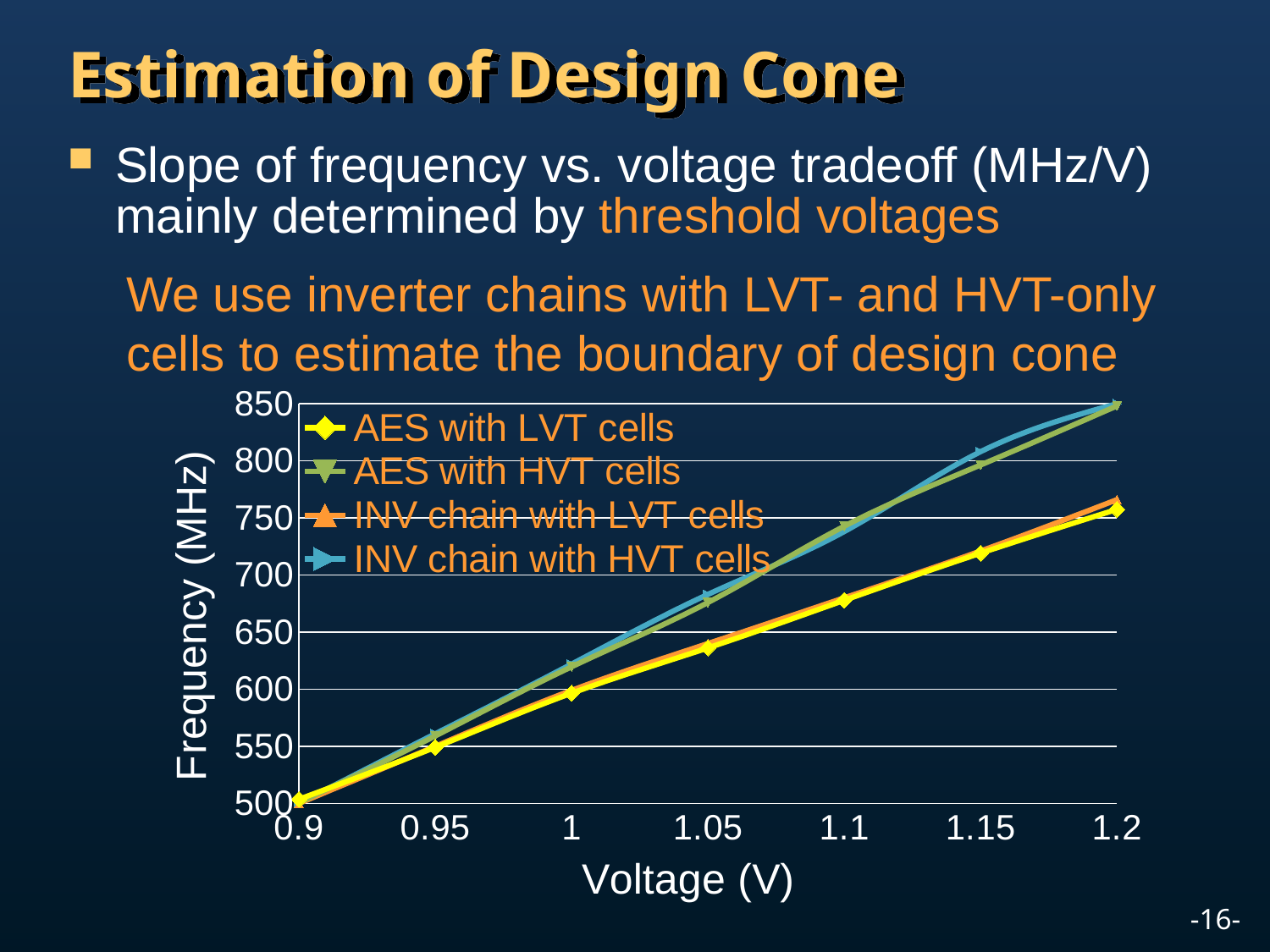
What kind of chart is shown on the slide? line chart Is the value for AES with HVT cells at 1.1 V greater or less than 700? greater Do the frequency values rise or fall as voltage increases from 0.9 V to 1.2 V? rise Is the value for AES with LVT cells at 1.1 V greater or less than 700? less Is the value for AES with LVT cells at 1.05 V greater or less than 650? less How many series does the legend list? 4 What is the label of the y axis? Frequency (MHz) At 1.2 V, which is larger: AES with HVT cells or AES with LVT cells? AES with HVT cells What is the label of the x axis? Voltage (V) How many voltage values are marked along the x axis? 7